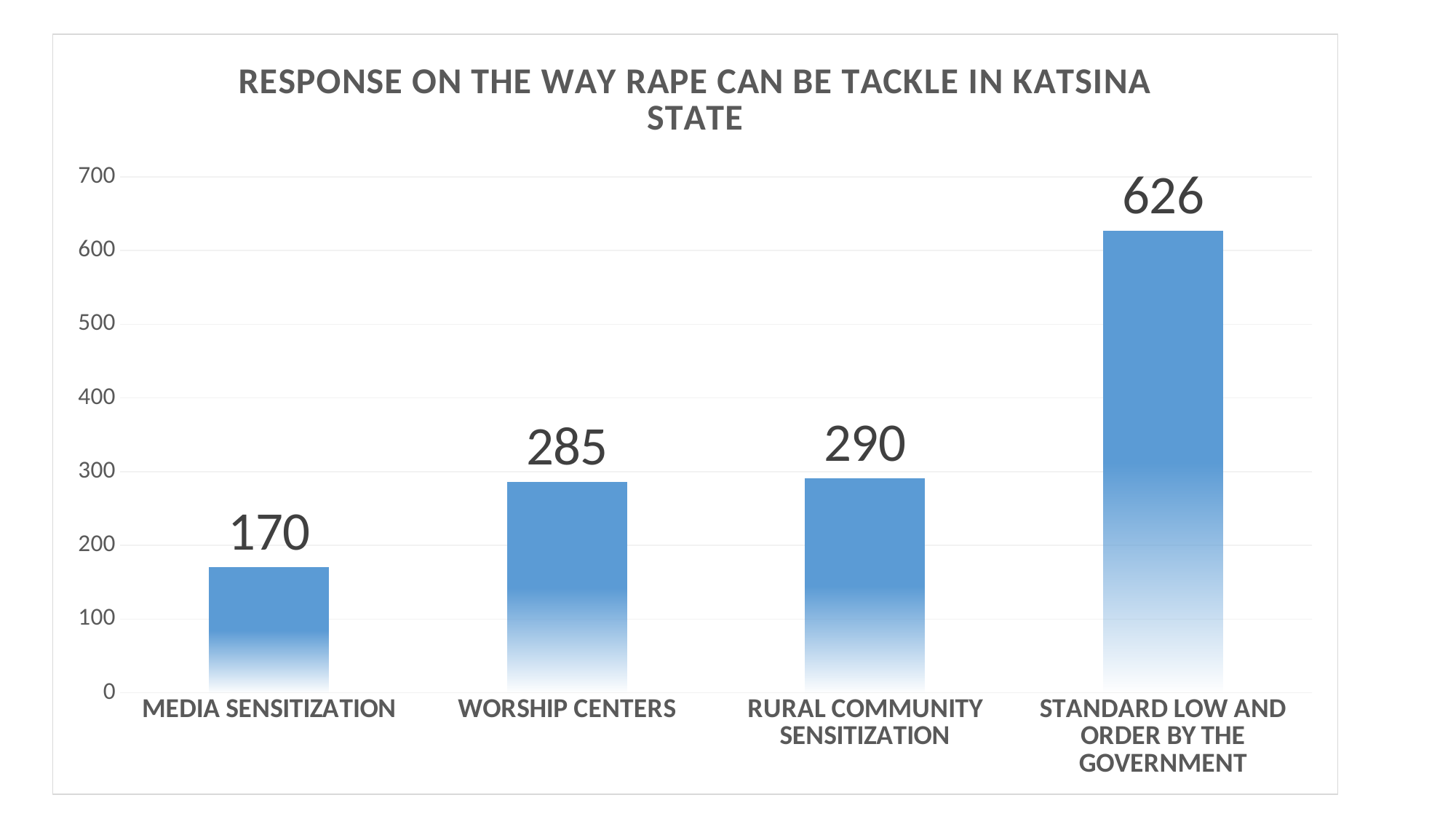
What kind of chart is shown on the slide? bar chart Which category has the lowest value? MEDIA SENSITIZATION Which category has the highest value? STANDARD LOW AND ORDER BY THE GOVERNMENT What is the value for RURAL COMMUNITY SENSITIZATION? 290 Which is larger, the value for WORSHIP CENTERS or the value for MEDIA SENSITIZATION? WORSHIP CENTERS What is the value for STANDARD LOW AND ORDER BY THE GOVERNMENT? 626 Is the value for STANDARD LOW AND ORDER BY THE GOVERNMENT greater or less than 600? greater What is the value for MEDIA SENSITIZATION? 170 How many categories are shown on the chart? 4 What is the difference between the values for RURAL COMMUNITY SENSITIZATION and WORSHIP CENTERS? 5 What is the difference between the values for STANDARD LOW AND ORDER BY THE GOVERNMENT and MEDIA SENSITIZATION? 456 What is the value for WORSHIP CENTERS? 285